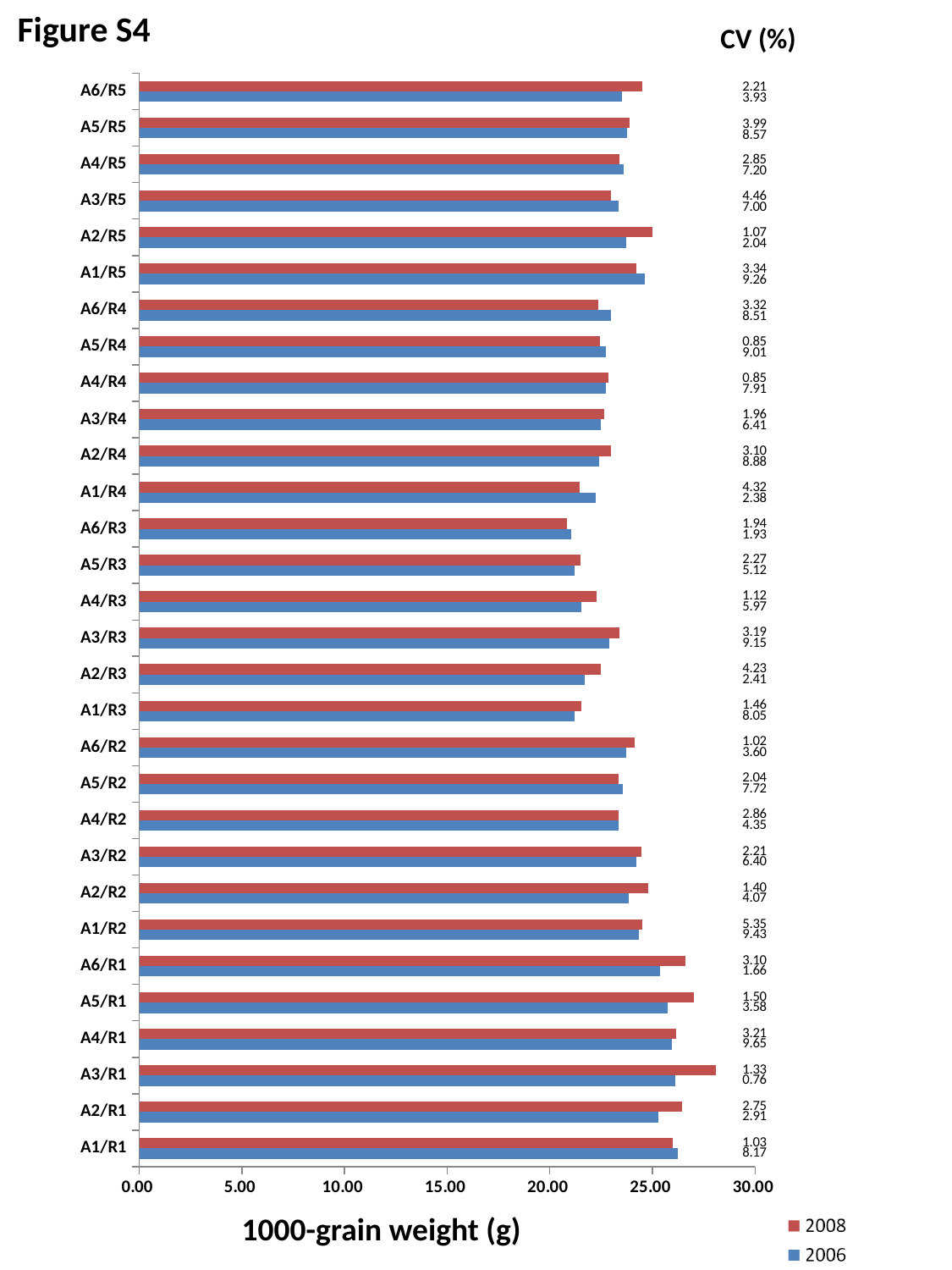
Which colour represents the 2006 series in the legend? blue For A2/R5, which series has the larger value, 2008 or 2006? 2008 Is the 2008 value for A3/R1 greater or less than 25.00? greater Is the 2008 value for A6/R3 greater or less than 25.00? less Is the 2006 value for A1/R1 greater or less than 25.00? greater What kind of chart is shown on the slide? bar chart For A3/R1, which series has the larger value, 2008 or 2006? 2008 How many categories are plotted on the chart? 30 What is the title of the x axis? 1000-grain weight (g) Which category has the longest 2008 bar? A3/R1 For A1/R4, which series has the larger value, 2008 or 2006? 2006 How many series does the legend list? 2